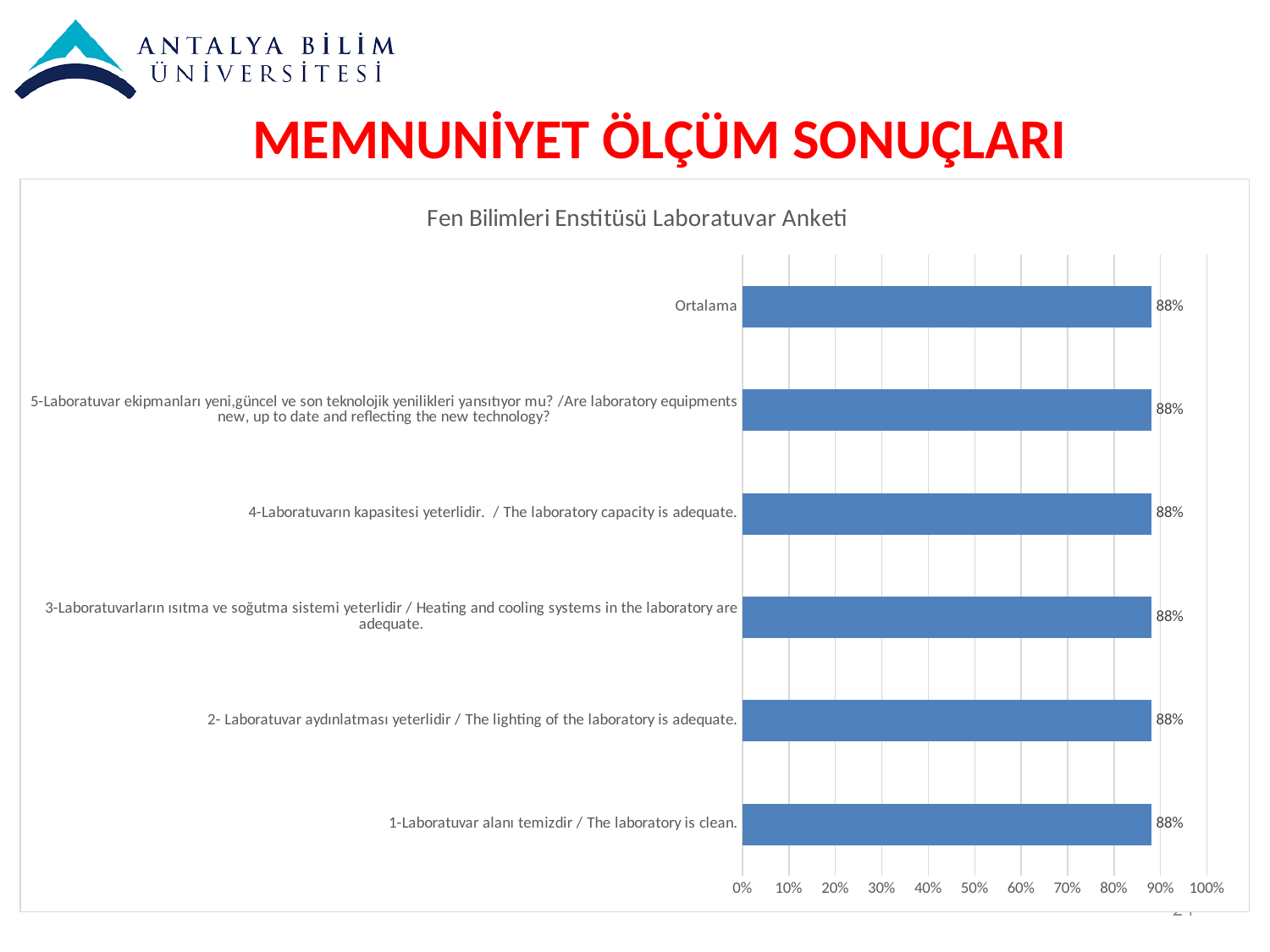
What kind of chart is shown on the slide? Bar chart What is the difference between the value for Ortalama and the value for "3-Laboratuvarların ısıtma ve soğutma sistemi yeterlidir"? 0% What is the value for Ortalama? 88% What is the value for "2- Laboratuvar aydınlatması yeterlidir / The lighting of the laboratory is adequate."? 88% What is the maximum value shown on the horizontal axis? 100% What is the value for "4-Laboratuvarın kapasitesi yeterlidir. / The laboratory capacity is adequate."? 88% What is the title of the chart? Fen Bilimleri Enstitüsü Laboratuvar Anketi How many categories (bars) are shown in the chart? 6 Is the value for Ortalama greater or less than 80%? greater What is the value for "1-Laboratuvar alanı temizdir / The laboratory is clean."? 88% Is the value for "5-Laboratuvar ekipmanları yeni,güncel ve son teknolojik yenilikleri yansıtıyor mu?" greater or less than 90%? less